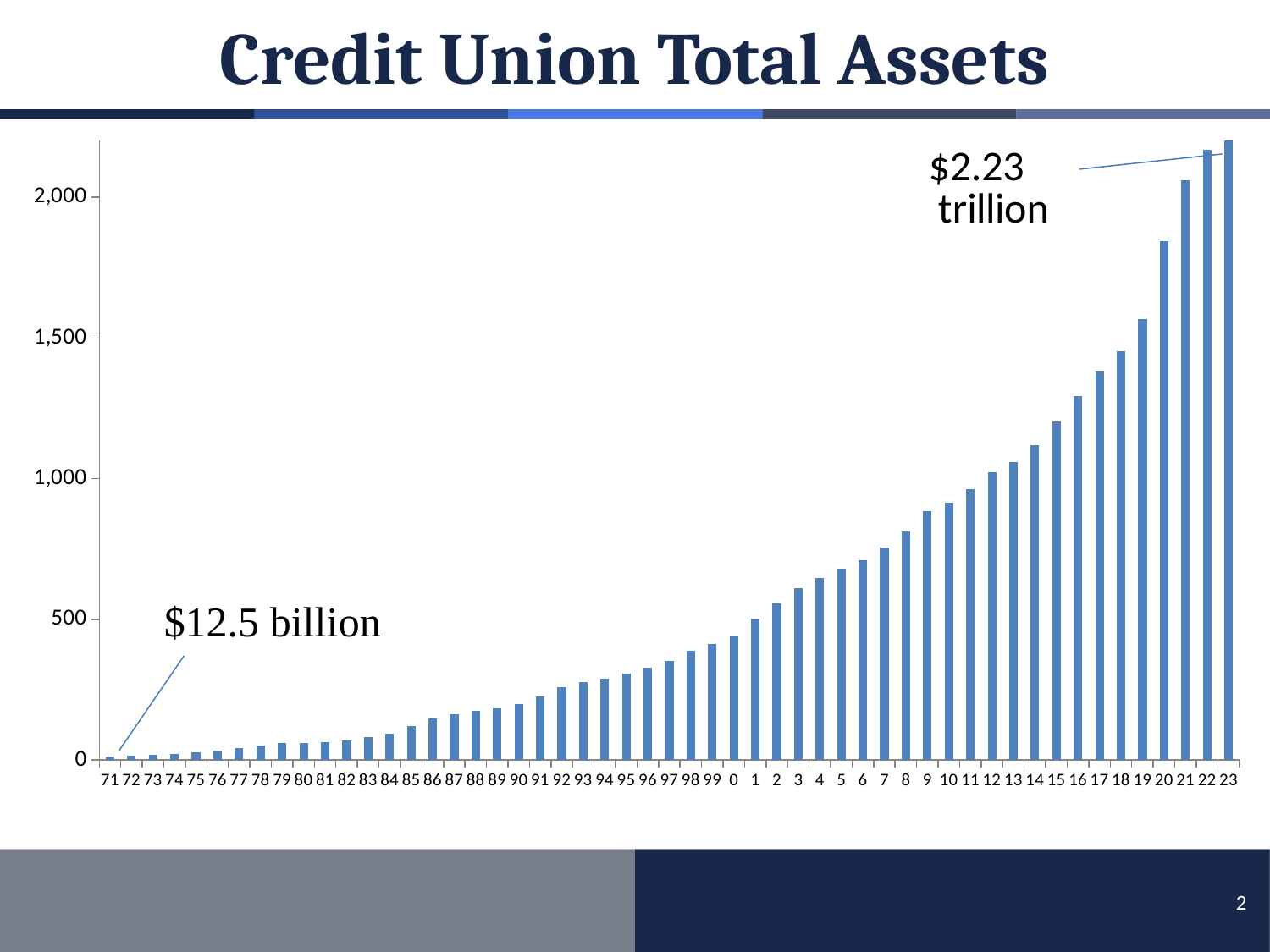
What value does the annotation give for credit union total assets in 71? $12.5 billion What kind of chart is shown on the slide? bar chart What is the title of the chart? Credit Union Total Assets Do credit union total assets rise or fall from 71 to 23? rise Which year has the highest total assets? 23 What value does the annotation give for credit union total assets in 23? $2.23 trillion Is the value for 0 greater or less than 500? less Which year has the lowest total assets? 71 How many years are plotted on the x axis? 53 Is the value for 20 greater or less than 1,500? greater Which is larger, the value for 21 or the value for 19? 21 Is the value for 10 greater or less than 1,000? less